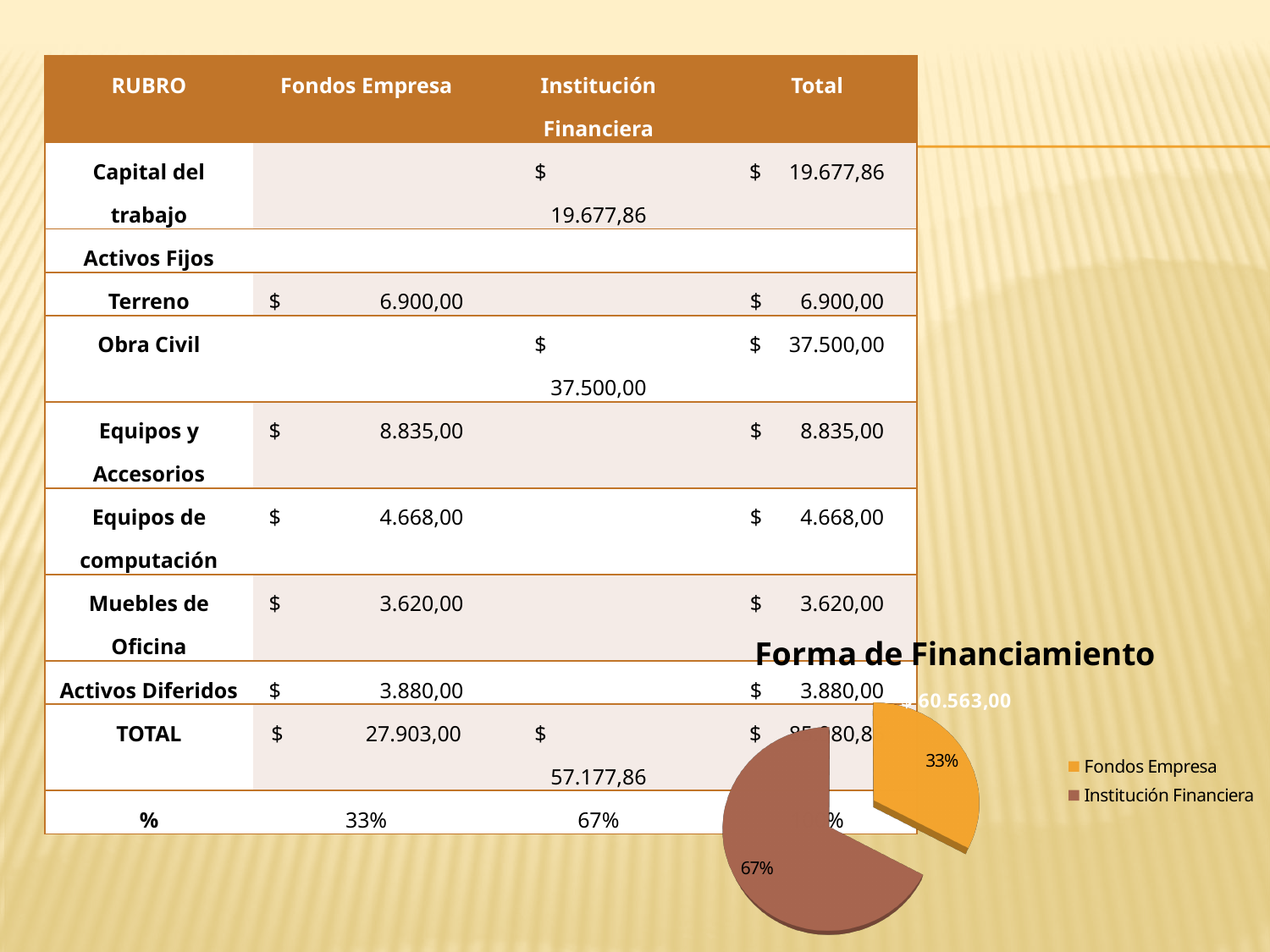
Is the share for Institución Financiera in the Forma de Financiamiento pie chart greater or less than 50%? greater In the Forma de Financiamiento pie chart, what share is labelled for Institución Financiera? 67% In the Forma de Financiamiento pie chart, which is larger: Fondos Empresa or Institución Financiera? Institución Financiera Which slice of the Forma de Financiamiento pie chart is the largest? Institución Financiera What kind of chart is shown on the slide? pie chart How many entries does the legend of the Forma de Financiamiento pie chart list? 2 What is the title of the chart on the slide? Forma de Financiamiento In the Forma de Financiamiento pie chart, what colour is the Institución Financiera slice? brown Which slice of the Forma de Financiamiento pie chart is the smallest? Fondos Empresa In the Forma de Financiamiento pie chart, what share is labelled for Fondos Empresa? 33% How many slices does the Forma de Financiamiento pie chart have? 2 In the Forma de Financiamiento pie chart, by how many percentage points does Institución Financiera exceed Fondos Empresa? 34 percentage points